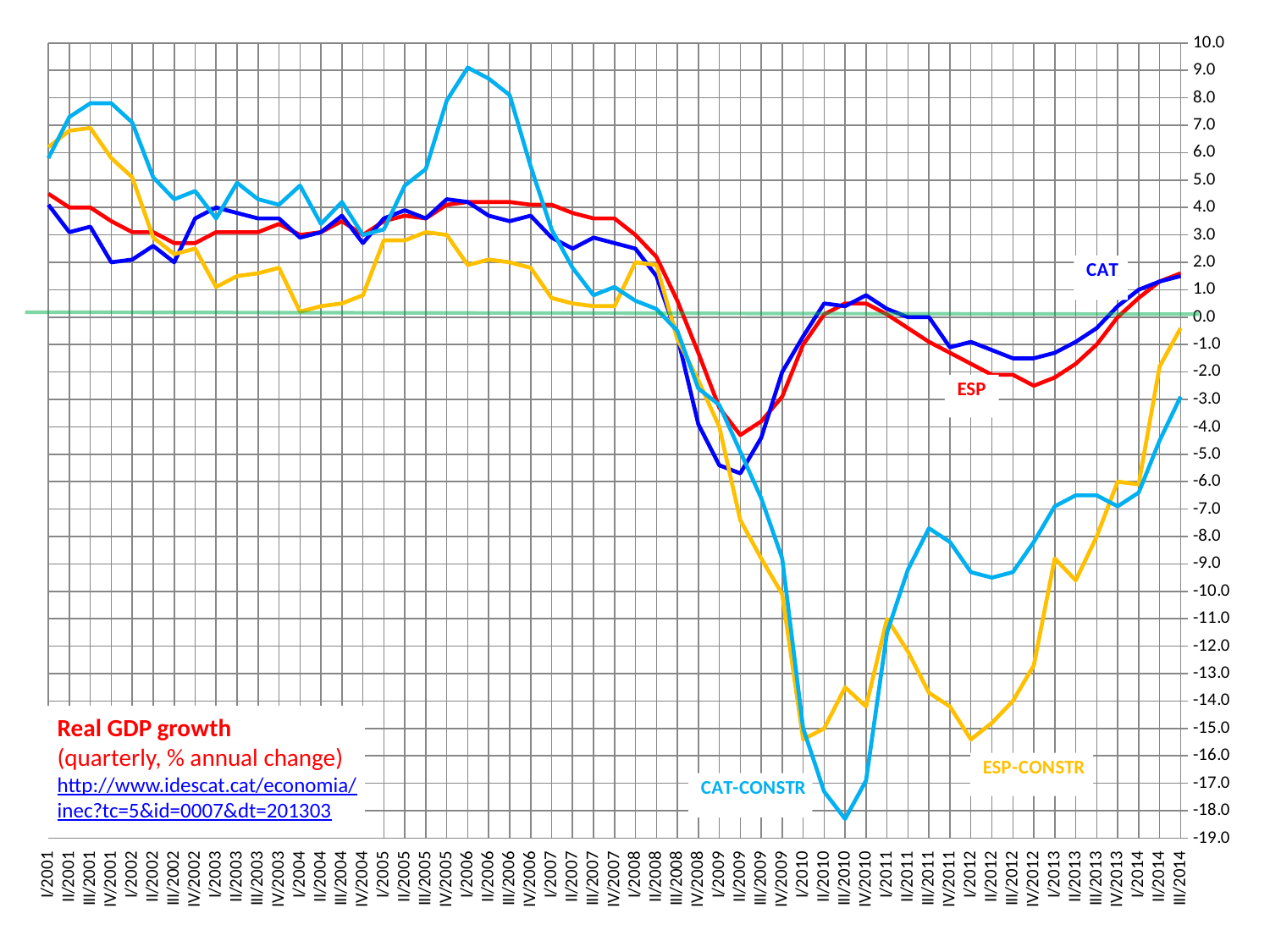
What colour is the CAT line? blue What kind of chart is shown on the slide? line chart At III/2014, which is higher, CAT-CONSTR or ESP-CONSTR? ESP-CONSTR Is the value for ESP-CONSTR at I/2012 greater or less than -14.0? less Which series reaches the lowest value anywhere on the chart? CAT-CONSTR Is the value for ESP at II/2009 greater or less than -3.0? less What is the title of the chart? Real GDP growth (quarterly, % annual change) Is the value for CAT-CONSTR at I/2006 greater or less than 8.0? greater Does the CAT-CONSTR line rise or fall between I/2006 and I/2010? fall How many data series are plotted on the chart? 4 Which series reaches the highest value anywhere on the chart? CAT-CONSTR